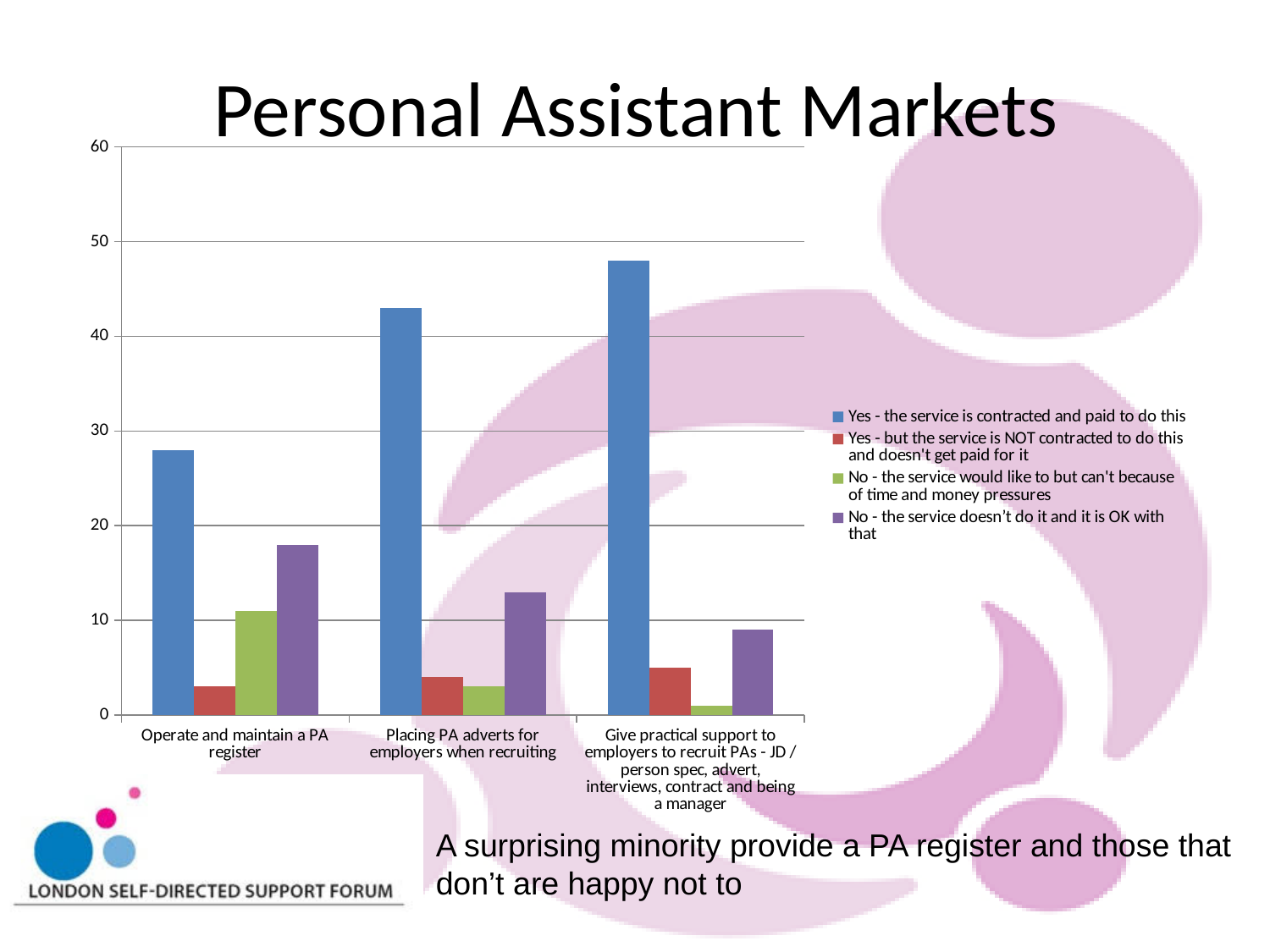
What is the title of the chart on the slide? Personal Assistant Markets Which category has the highest value for the series 'No - the service would like to but can't because of time and money pressures'? Operate and maintain a PA register Is the value for 'No - the service doesn't do it and it is OK with that' in the 'Operate and maintain a PA register' category greater or less than 20? less Which category has the highest value for the series 'Yes - the service is contracted and paid to do this'? Give practical support to employers to recruit PAs - JD / person spec, advert, interviews, contract and being a manager Does the value for 'Yes - the service is contracted and paid to do this' rise or fall across the categories from left to right? rise Is the value for 'Yes - the service is contracted and paid to do this' in the 'Placing PA adverts for employers when recruiting' category greater or less than 40? greater Which category has the lowest value for the series 'Yes - the service is contracted and paid to do this'? Operate and maintain a PA register Is the value for 'Yes - the service is contracted and paid to do this' in the 'Operate and maintain a PA register' category greater or less than 30? less What kind of chart is shown on the slide? bar chart How many categories are shown along the x axis of the chart? 3 In the 'Give practical support to employers to recruit PAs' category, which is larger: the value for 'Yes - but the service is NOT contracted to do this and doesn't get paid for it' or the value for 'No - the service doesn't do it and it is OK with that'? No - the service doesn't do it and it is OK with that How many series does the chart's legend list? 4